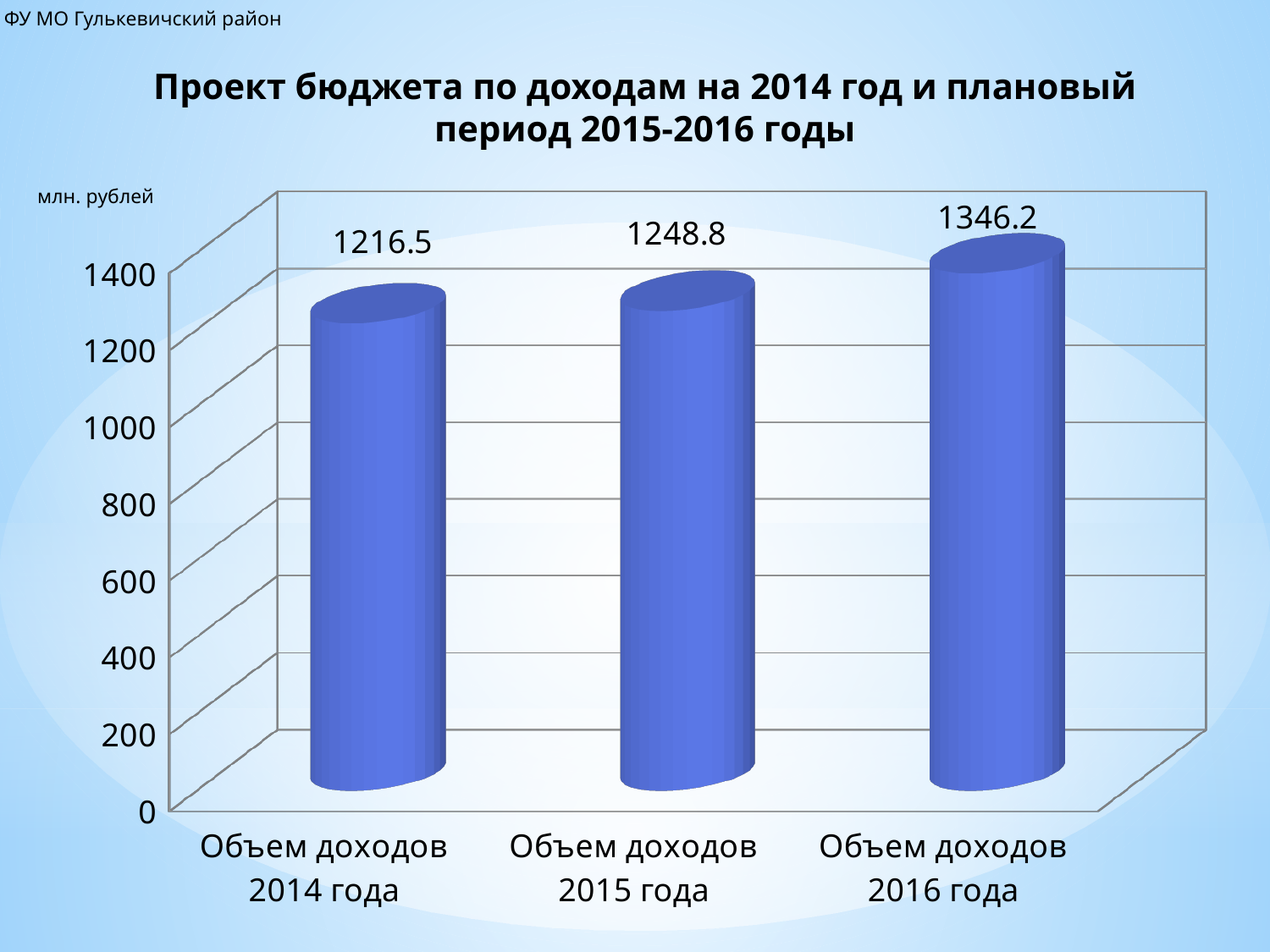
What kind of chart is shown on the slide? bar chart What is the difference between the values for Объем доходов 2015 года and Объем доходов 2014 года? 32.3 Which category has the highest value? Объем доходов 2016 года What is the difference between the values for Объем доходов 2016 года and Объем доходов 2014 года? 129.7 Which category has the lowest value? Объем доходов 2014 года How many categories are shown in the chart? 3 Do the values rise or fall from 2014 to 2016? rise What is the value for Объем доходов 2014 года? 1216.5 What is the value for Объем доходов 2015 года? 1248.8 Which is larger, the value for Объем доходов 2015 года or Объем доходов 2016 года? Объем доходов 2016 года What is the value for Объем доходов 2016 года? 1346.2 Is the value for Объем доходов 2014 года greater or less than 1400? less